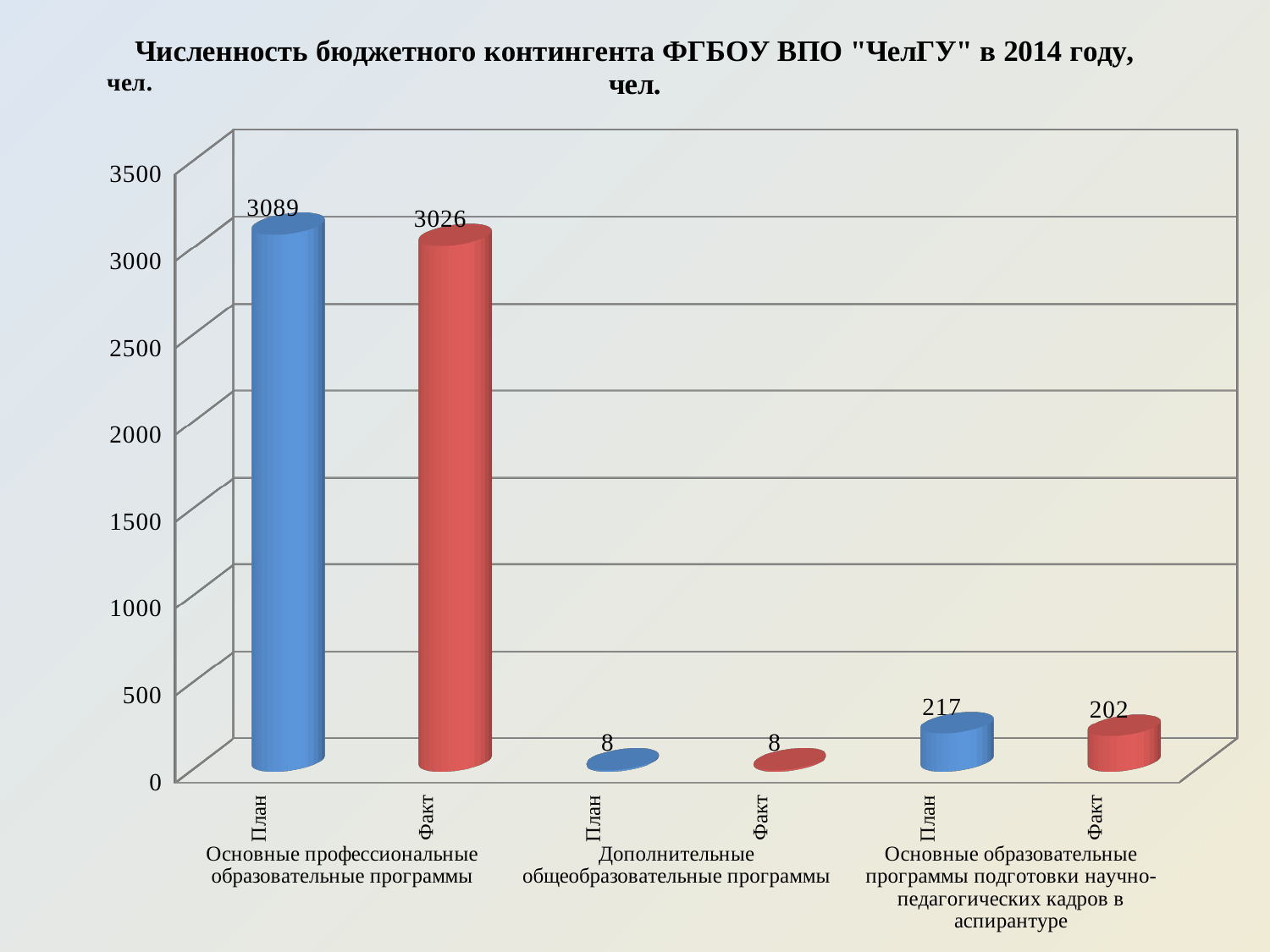
What is the value of the Факт bar for Основные профессиональные образовательные программы? 3026 Which is larger for the aspirantura programmes (научно-педагогических кадров в аспирантуре): План or Факт? План Which bar has the highest value on the chart? План, Основные профессиональные образовательные программы How many bars are plotted on the chart? 6 What is the difference between the План and Факт values for Основные профессиональные образовательные программы? 63 Is the Факт value for Основные профессиональные образовательные программы greater or less than 3000? greater What is the value of the План bar for Основные профессиональные образовательные программы? 3089 What is the value of the Факт bar for Основные образовательные программы подготовки научно-педагогических кадров в аспирантуре? 202 What is the value of the План bar for Дополнительные общеобразовательные программы? 8 What is the unit of measurement shown on the chart's vertical axis? чел. What is the difference between the План and Факт values for Основные образовательные программы подготовки научно-педагогических кадров в аспирантуре? 15 What kind of chart is shown on the slide? Bar chart